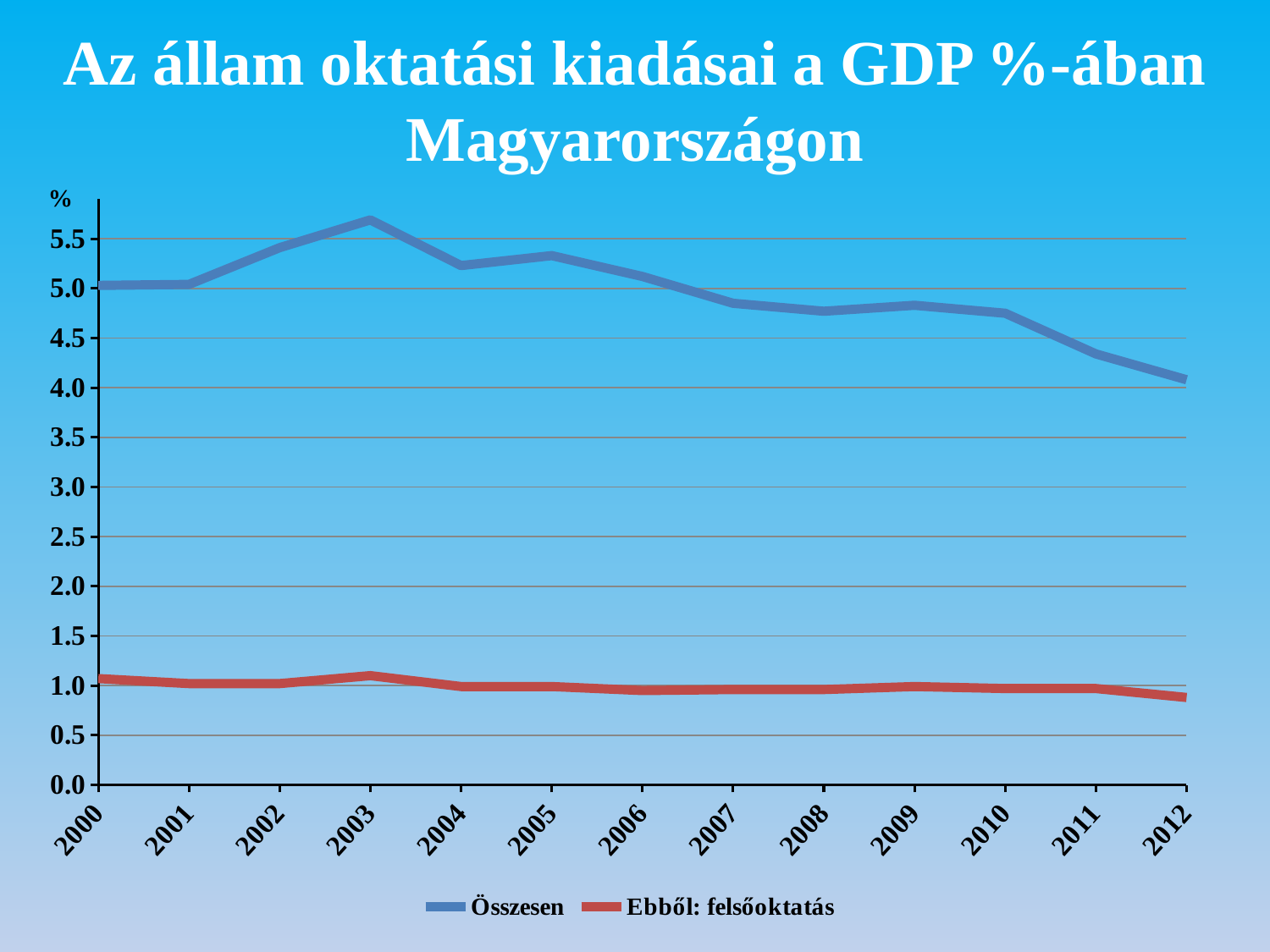
Is the value for Összesen in 2012 greater or less than 4.5? less How many years are plotted along the x axis? 13 Is the value for Összesen in 2007 greater or less than 5.0? less In which year does the Összesen series reach its highest value? 2003 In which year does the Ebből: felsőoktatás series reach its lowest value? 2012 In which year does the Összesen series reach its lowest value? 2012 Is the value for Ebből: felsőoktatás in 2012 greater or less than 1.0? less What kind of chart is shown on the slide? line chart Which series is shown in red in the legend? Ebből: felsőoktatás How many series does the legend list? 2 Does the Összesen series rise or fall from 2003 to 2012? fall